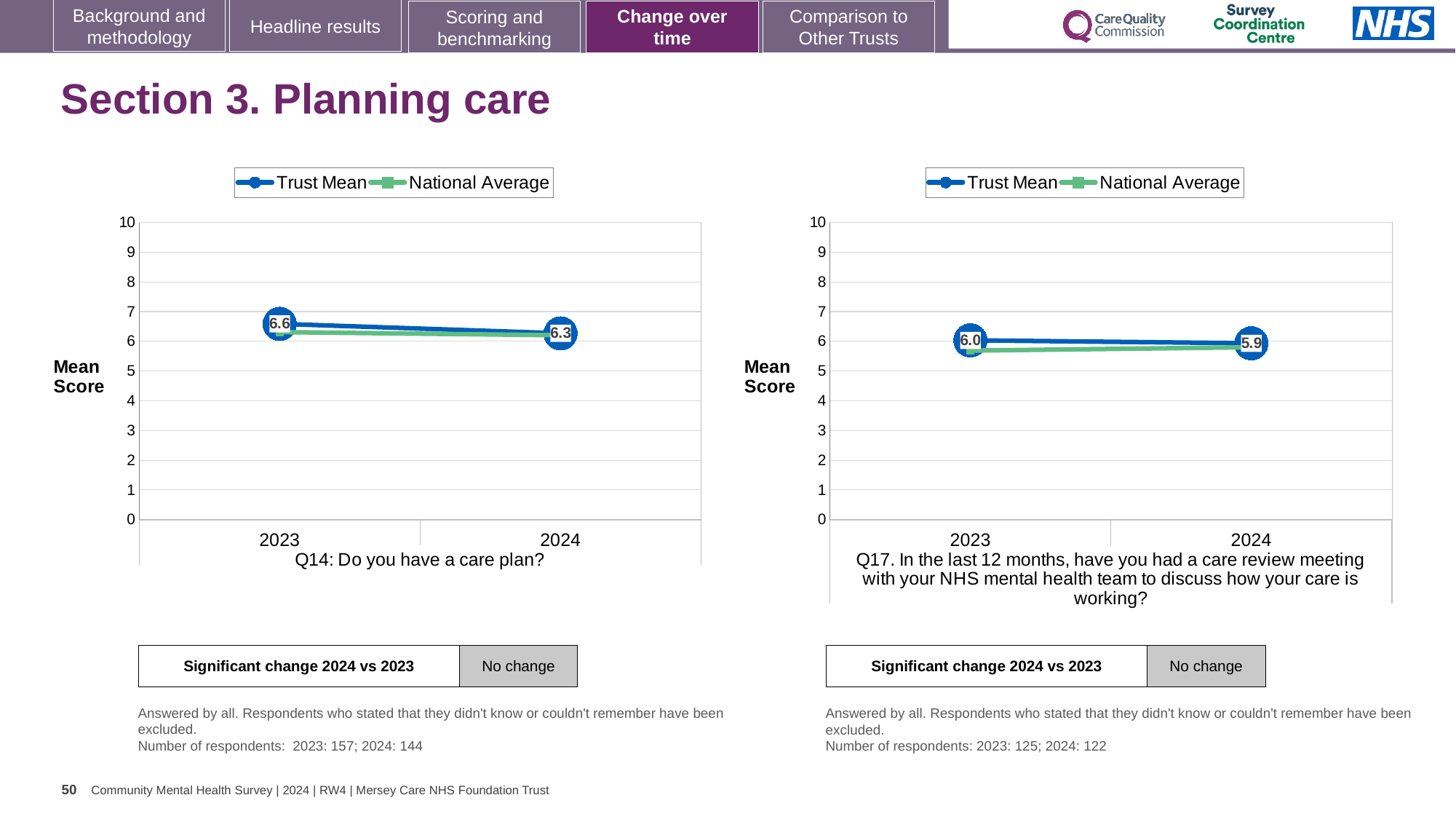
How many years are shown on the x axis of the Q14 chart on the left? 2 In the Q17 chart on the right, what is the Trust Mean for 2023? 6.0 In the Q14 chart on the left, does the Trust Mean rise or fall from 2023 to 2024? fall In the Q14 chart on the left, which series is drawn in green? National Average In the Q14 chart on the left, what is the Trust Mean for 2023? 6.6 In the Q17 chart on the right, is the National Average for 2023 greater or less than 5? greater In the Q17 chart on the right, what is the Trust Mean for 2024? 5.9 In the Q17 chart on the right, which year has the higher Trust Mean, 2023 or 2024? 2023 What kind of chart is the Q14 chart on the left? line chart In the Q14 chart on the left, by how much did the Trust Mean change from 2023 to 2024? 0.3 How many series does the legend of the Q17 chart on the right list? 2 In the Q14 chart on the left, what is the Trust Mean for 2024? 6.3